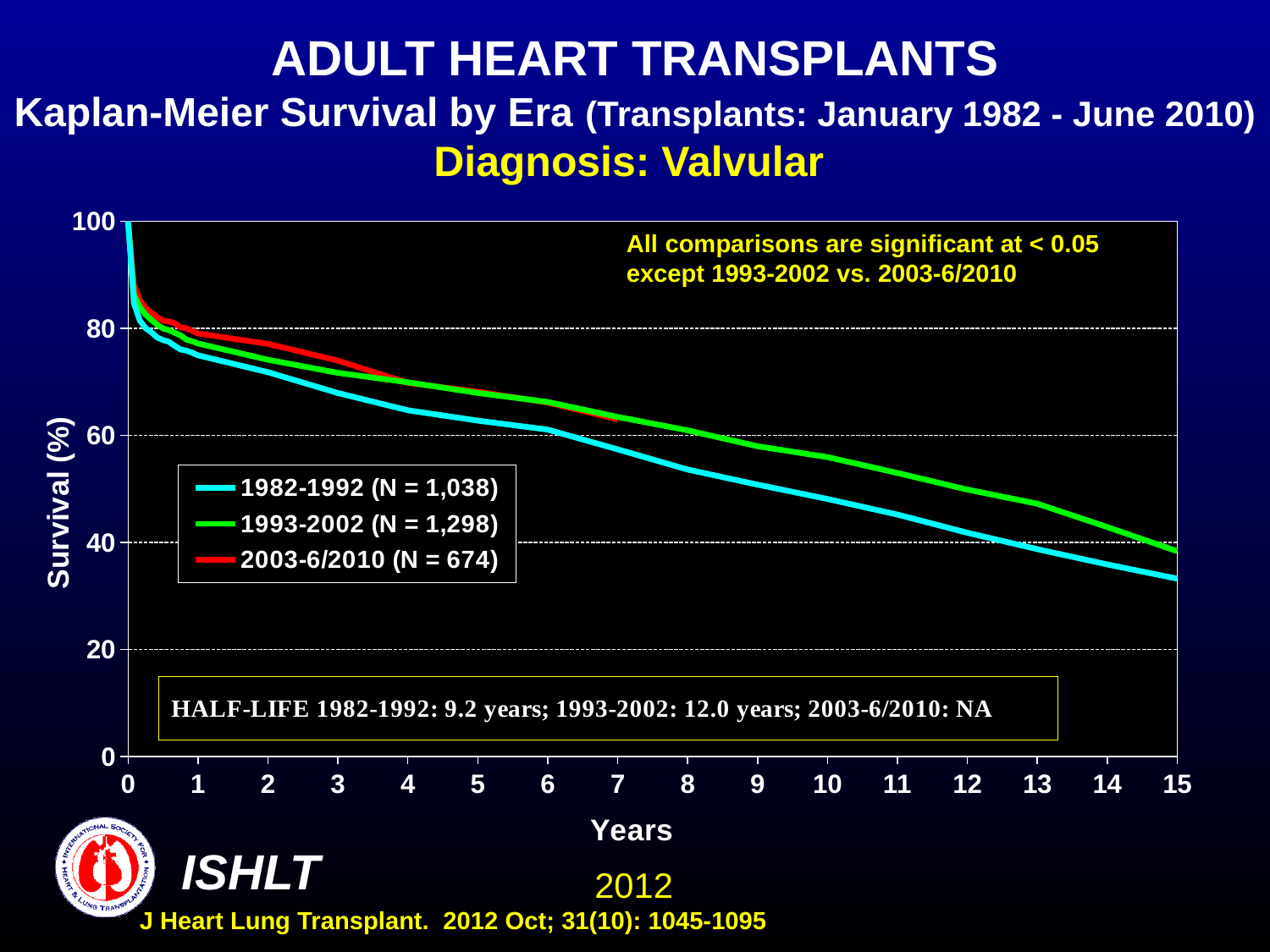
Do the survival curves rise or fall as years increase? fall At 10 years, which series has higher survival: 1982-1992 or 1993-2002? 1993-2002 What is the half-life for the 1993-2002 era? 12.0 years What is the N for the 1993-2002 series in the legend? 1,298 What is the N for the 2003-6/2010 series in the legend? 674 How many series does the legend list? 3 What kind of chart is shown on the slide? line chart What is the half-life given for the 2003-6/2010 era? NA Is the survival for the 1993-2002 series at 5 years greater or less than 60? greater What is the half-life for the 1982-1992 era? 9.2 years What is the label on the y axis? Survival (%) Is the survival for the 1982-1992 series at 10 years greater or less than 60? less